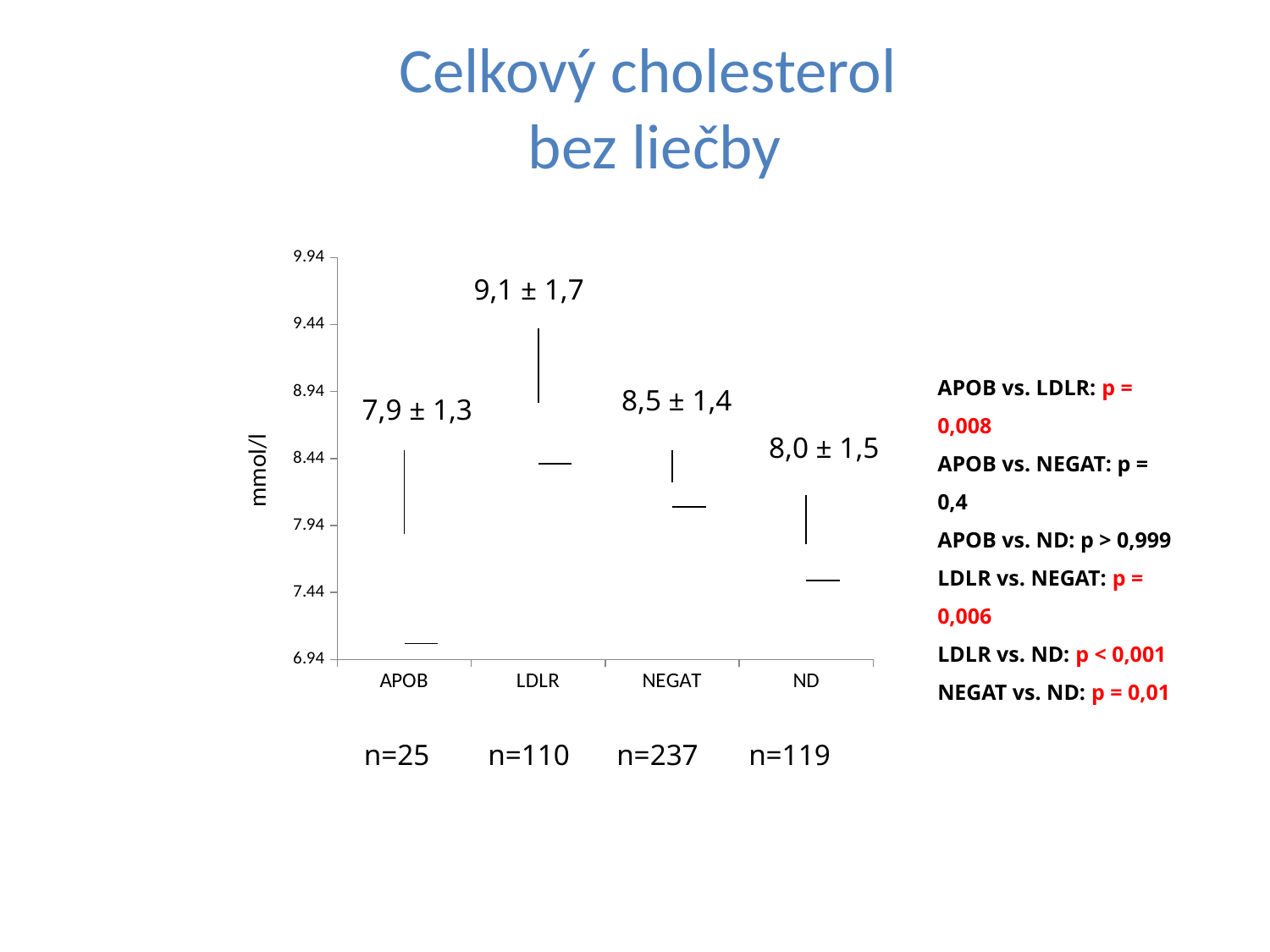
What value is labelled for the NEGAT group? 8,5 ± 1,4 Which group has the highest mean total cholesterol? LDLR What is the difference between the mean values of LDLR and APOB? 1,2 What is the title of the slide? Celkový cholesterol bez liečby What value is labelled for the ND group? 8,0 ± 1,5 What unit is shown on the y axis? mmol/l How many groups are shown on the x axis? 4 What value is labelled for the APOB group? 7,9 ± 1,3 Which group has a higher mean value, NEGAT or ND? NEGAT What is the sample size (n) shown for the NEGAT group? n=237 What value is labelled for the LDLR group? 9,1 ± 1,7 Which group has the lowest mean total cholesterol? APOB